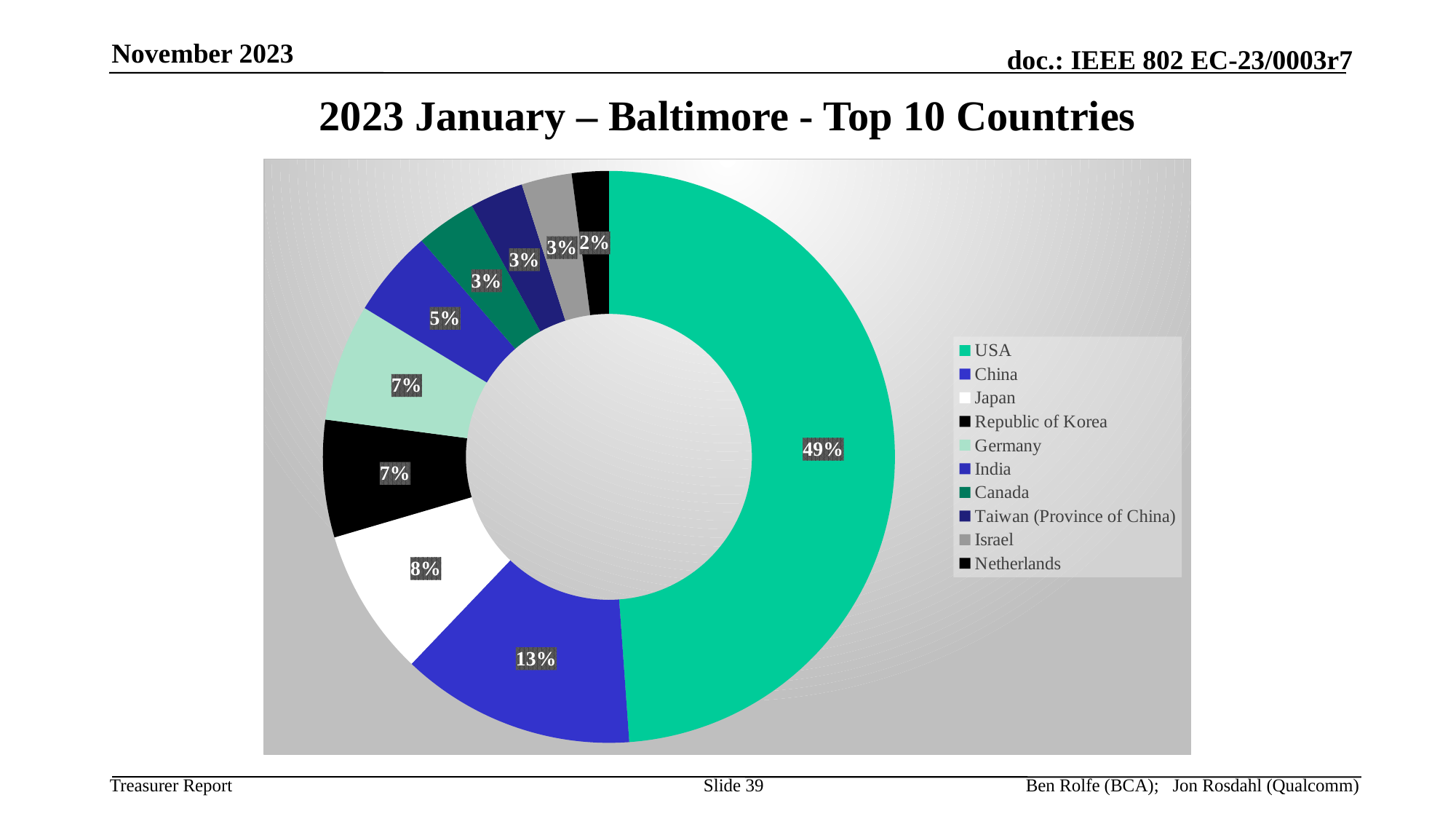
Which country has the smallest share of the chart? Netherlands What is the value shown for Germany? 7% What kind of chart is shown on the slide? Doughnut chart Which country has the largest share of the chart? USA What is the value shown for China? 13% What is the difference between the shares for USA and China? 36% What is the title of the slide? 2023 January – Baltimore - Top 10 Countries What is the value shown for Japan? 8% Which has a larger share, Japan or India? Japan What is the value shown for India? 5% How many countries are shown in the chart? 10 What share of the chart does USA account for? 49%